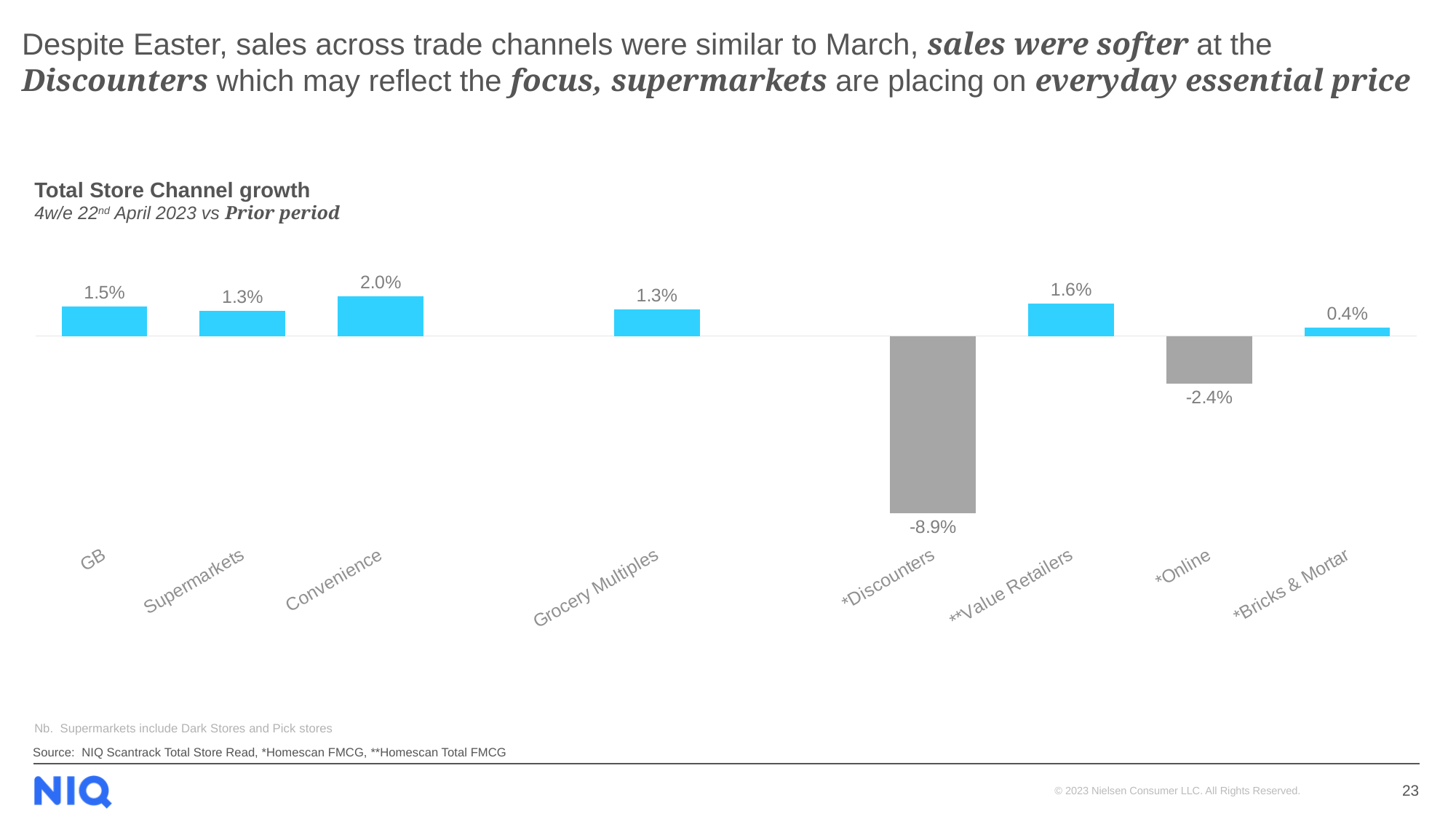
What is the growth value for Discounters? -8.9% Which is larger, the growth for GB or the growth for Supermarkets? GB What is the growth value for Convenience? 2.0% How many channels are shown in the chart? 8 Which channel has the highest growth? Convenience What is the difference between the growth for Value Retailers and GB? 0.1% How many channels show negative growth? 2 What period does the chart compare, according to its subtitle? 4w/e 22nd April 2023 vs Prior period What is the growth value for Online? -2.4% What kind of chart is shown on the slide? Bar chart Which channel has the lowest growth? Discounters What is the growth value for Bricks & Mortar? 0.4%